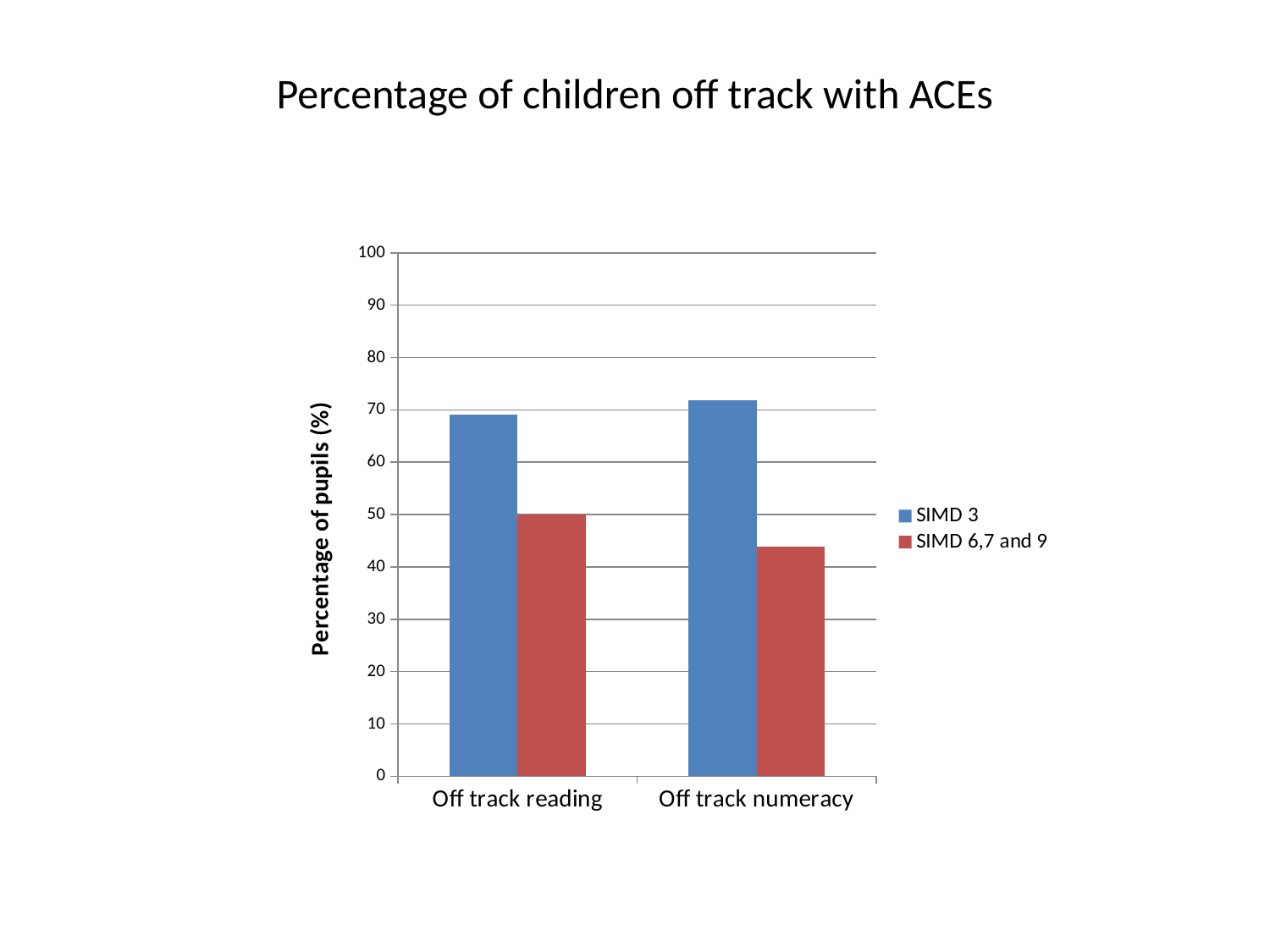
What kind of chart is shown on the slide? bar chart Is the SIMD 3 value for Off track reading greater or less than 60? greater Which series has the higher value for Off track numeracy, SIMD 3 or SIMD 6,7 and 9? SIMD 3 Is the SIMD 6,7 and 9 value for Off track numeracy greater or less than 50? less Is the SIMD 3 value for Off track numeracy greater or less than 70? greater Which bar in the chart is the tallest? SIMD 3, Off track numeracy Which bar in the chart is the shortest? SIMD 6,7 and 9, Off track numeracy What is the label on the vertical axis? Percentage of pupils (%) How many categories are shown on the x axis? 2 How many series does the legend list? 2 Which series has the higher value for Off track reading, SIMD 3 or SIMD 6,7 and 9? SIMD 3 What is the title of the chart? Percentage of children off track with ACEs